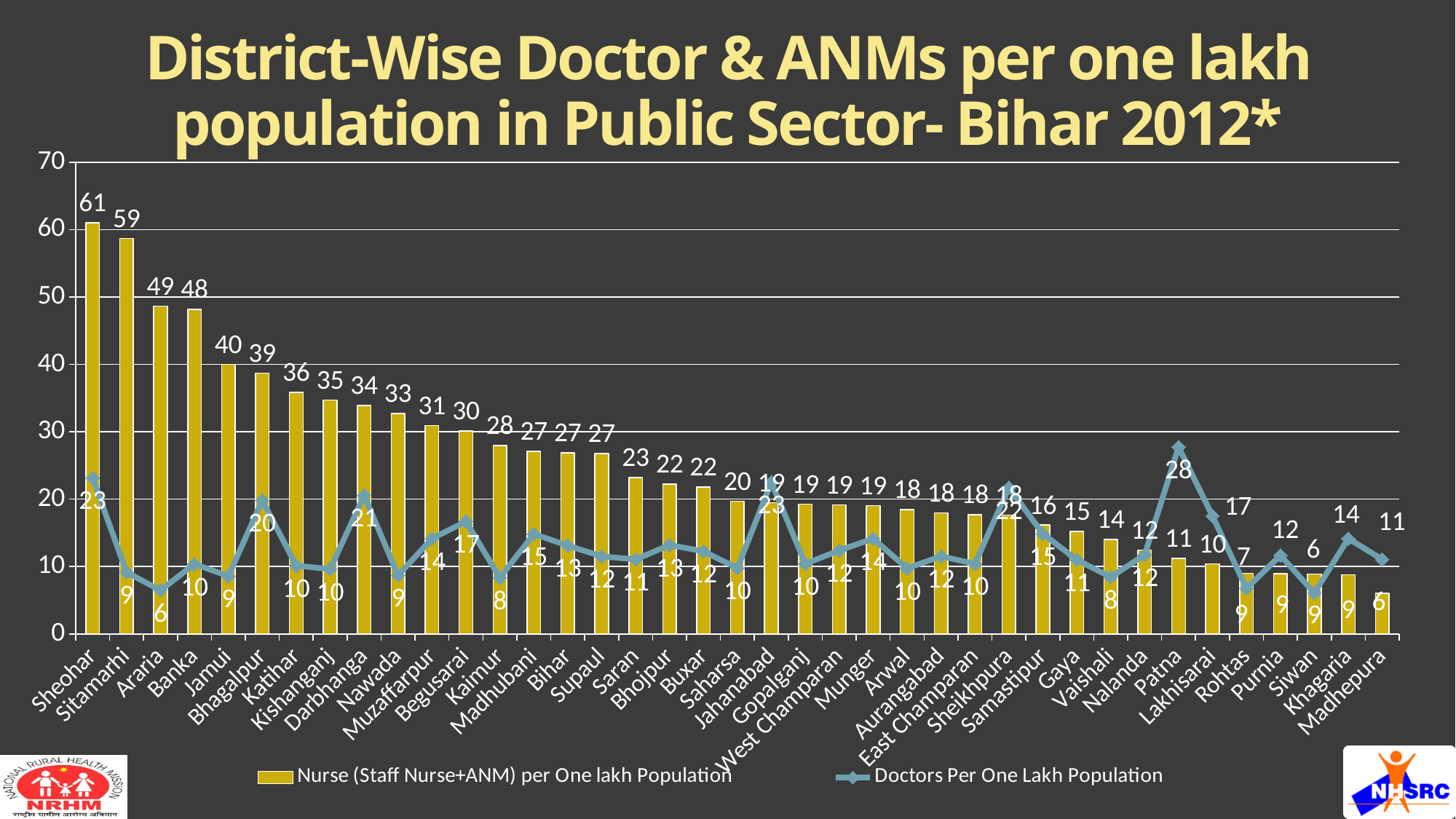
What colour are the bars for Nurse (Staff Nurse+ANM) per One lakh Population? Yellow/gold Do the Nurse (Staff Nurse+ANM) per One lakh Population bars generally rise or fall from left to right? fall What is the difference between the nurse values for Sheohar and Sitamarhi? 2 Which has more Doctors Per One Lakh Population, Bhagalpur or Katihar? Bhagalpur What kind of chart is shown on the slide? A bar chart combined with a line What is the value of Doctors Per One Lakh Population for Patna? 28 What is the value of Doctors Per One Lakh Population for Darbhanga? 21 Which district has the highest Doctors Per One Lakh Population? Patna What is the value of Nurse (Staff Nurse+ANM) per One lakh Population for Sheohar? 61 How many series does the legend list? 2 Is the Nurse (Staff Nurse+ANM) per One lakh Population value for Bihar greater or less than 20? greater Which district has the highest Nurse (Staff Nurse+ANM) per One lakh Population? Sheohar